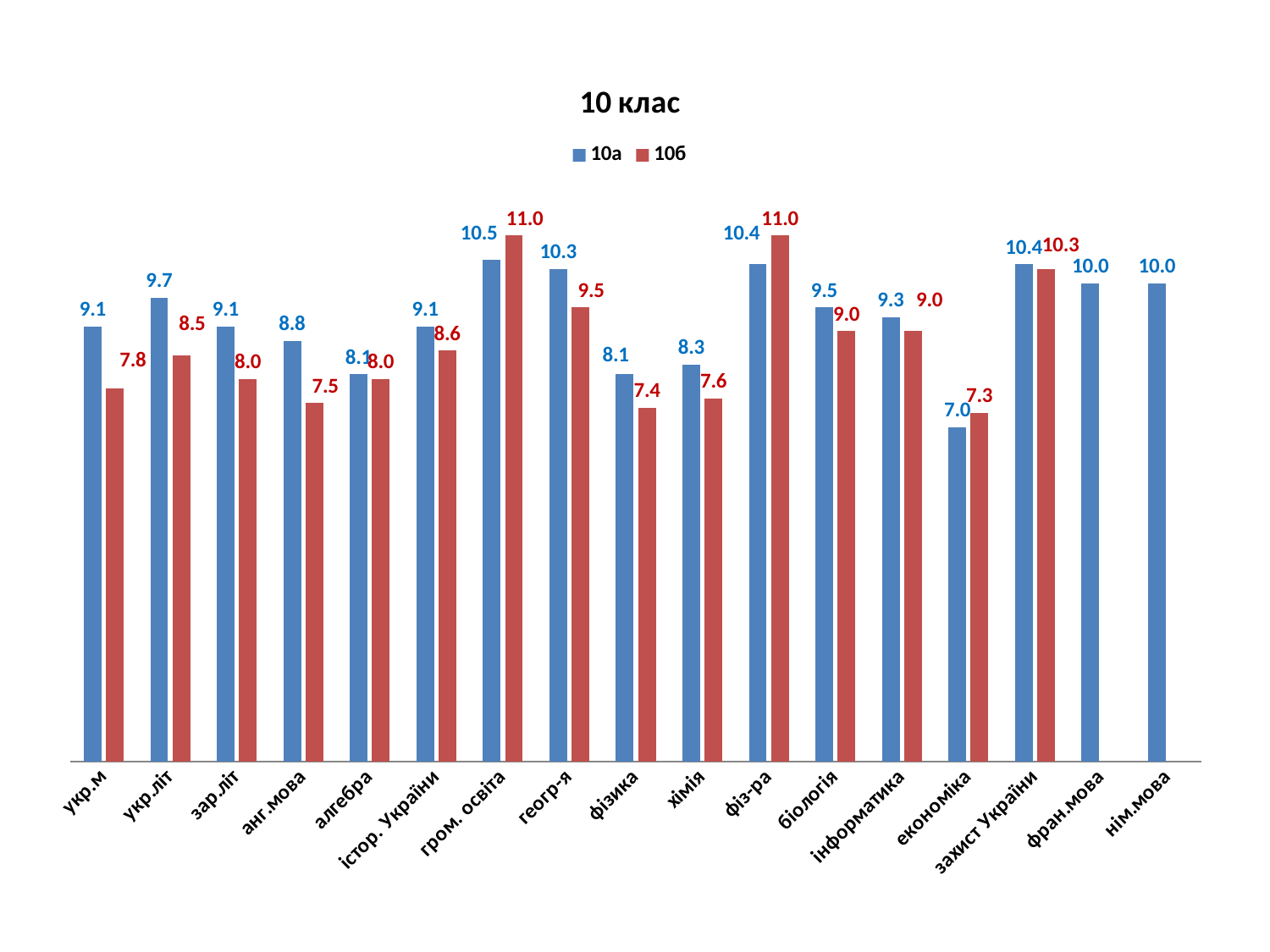
How many subjects are shown on the x axis? 17 What is the value for 10а in гром. освіта? 10.5 How many series does the legend list? 2 What is the value for 10б in анг.мова? 7.5 What is the difference between 10а and 10б in геогр-я? 0.8 Which subject has the lowest value for 10б? економіка Which is larger in фіз-ра, the value for 10а or for 10б? 10б What is the value for 10а in економіка? 7.0 Which is larger in хімія, the value for 10а or for 10б? 10а What is the difference between 10а and 10б in укр.м? 1.3 Which subject has the highest value for 10а? гром. освіта What type of chart is shown on the slide? bar chart